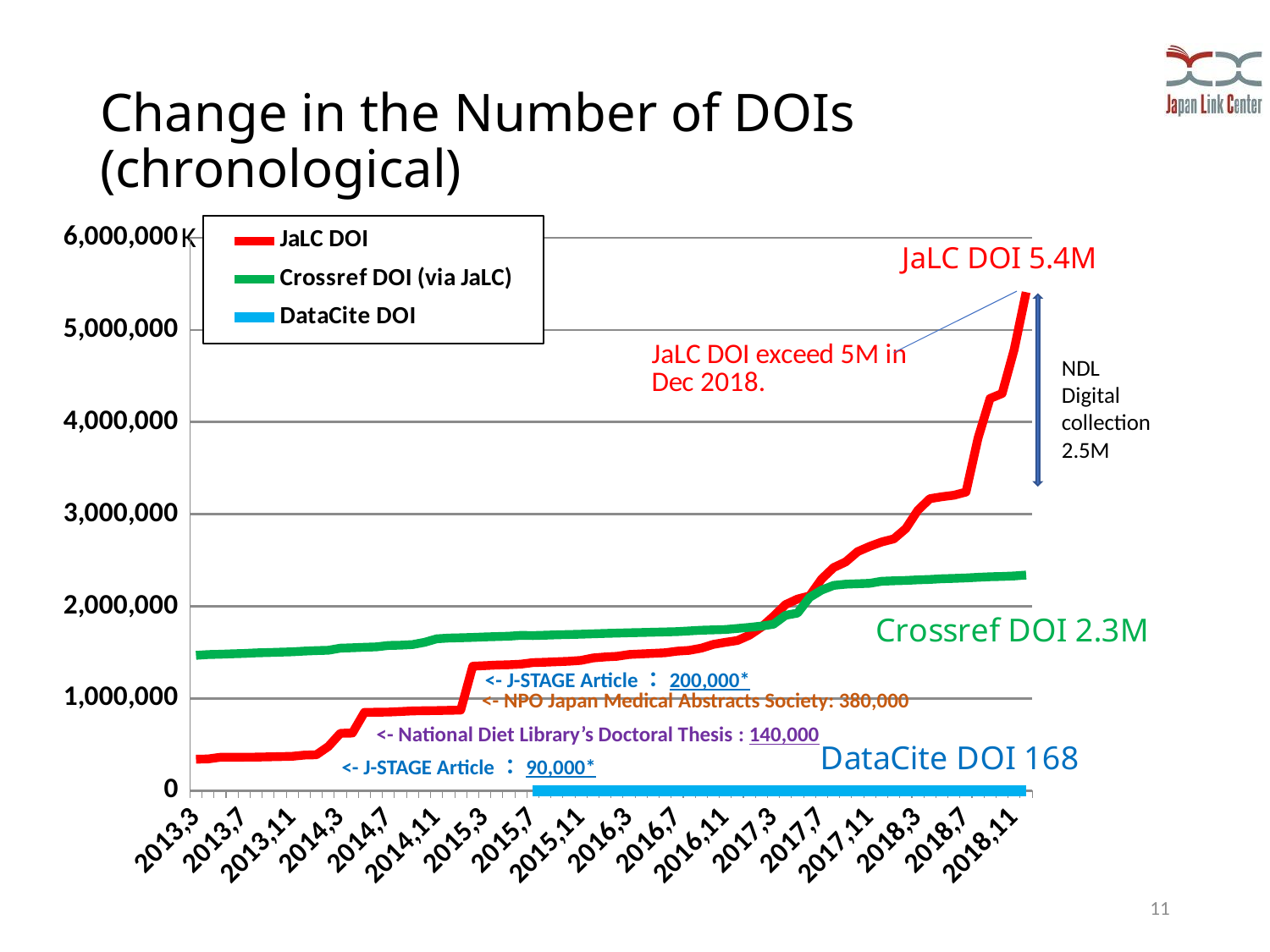
Is the value for JaLC DOI at 2018.11 greater or less than 5,000,000? less At 2013.3, which series has the higher value: JaLC DOI or Crossref DOI (via JaLC)? Crossref DOI (via JaLC) What kind of chart is shown on the slide? Line chart Is the value for JaLC DOI at 2013.3 greater or less than 1,000,000? less What is the title of the chart? Change in the Number of DOIs (chronological) Does the JaLC DOI line rise or fall from 2013.3 to 2018.11? Rise Which series has the highest value at 2018.11? JaLC DOI According to the annotation, what is the number of JaLC DOIs at the end of the chart? 5.4M Is the value for Crossref DOI (via JaLC) at 2013.3 greater or less than 1,000,000? greater According to the annotation, what is the number of Crossref DOIs at the end of the chart? 2.3M How many series does the legend list? 3 According to the annotation, what is the number of DataCite DOIs? 168